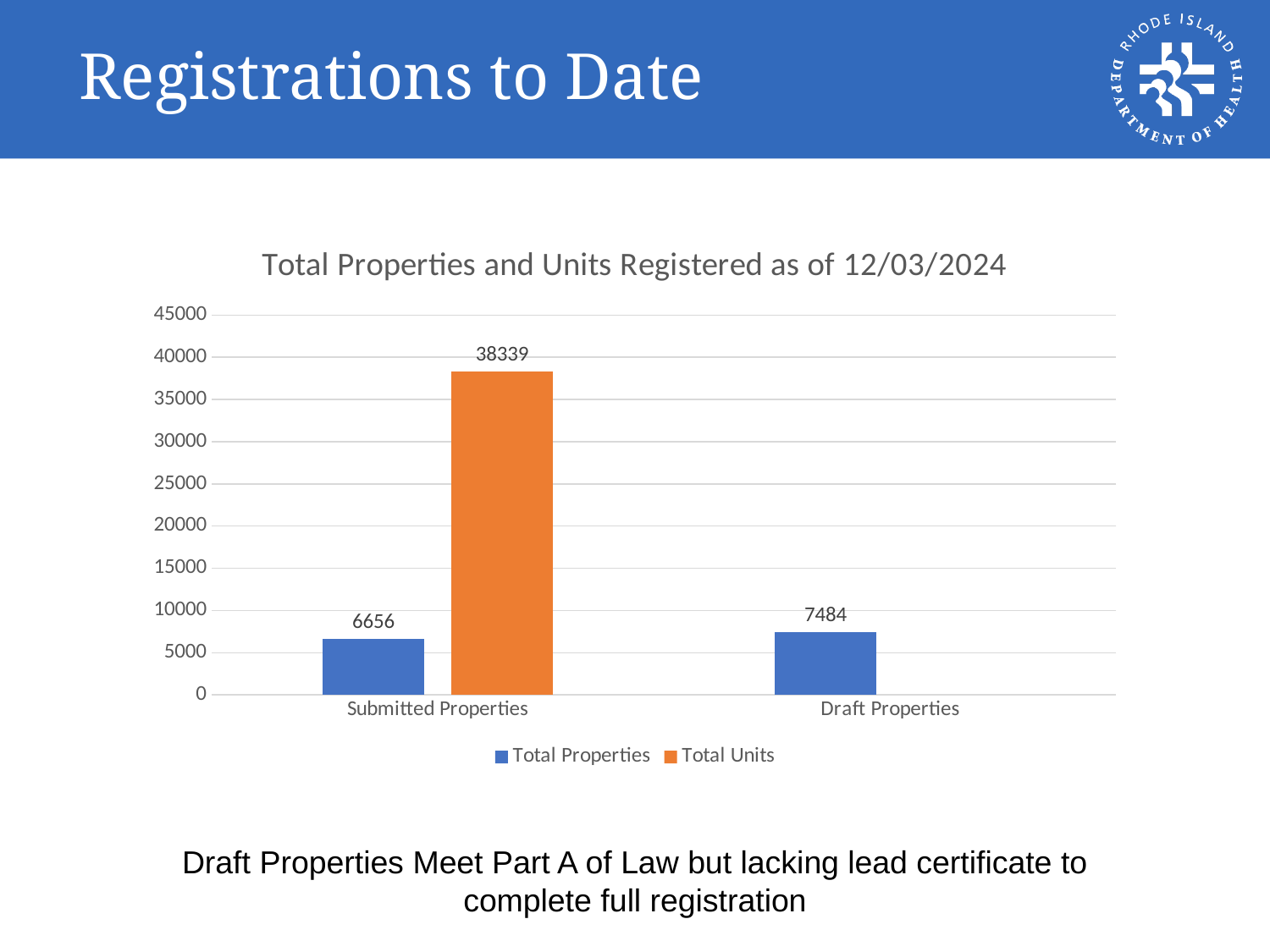
What is the title of the chart? Total Properties and Units Registered as of 12/03/2024 What is the Total Properties value for Draft Properties? 7484 What type of chart is shown on the slide? Bar chart What is the difference between Total Units and Total Properties for Submitted Properties? 31683 Is the Total Units value for Submitted Properties greater or less than 35000? greater What is the difference between the Total Properties values for Draft Properties and Submitted Properties? 828 What is the Total Properties value for Submitted Properties? 6656 Which category has the higher Total Properties value, Submitted Properties or Draft Properties? Draft Properties How many series does the legend list? 2 Is the Total Properties value for Draft Properties greater or less than 10000? less What is the Total Units value for Submitted Properties? 38339 Which bar in the chart has the highest value? Total Units for Submitted Properties